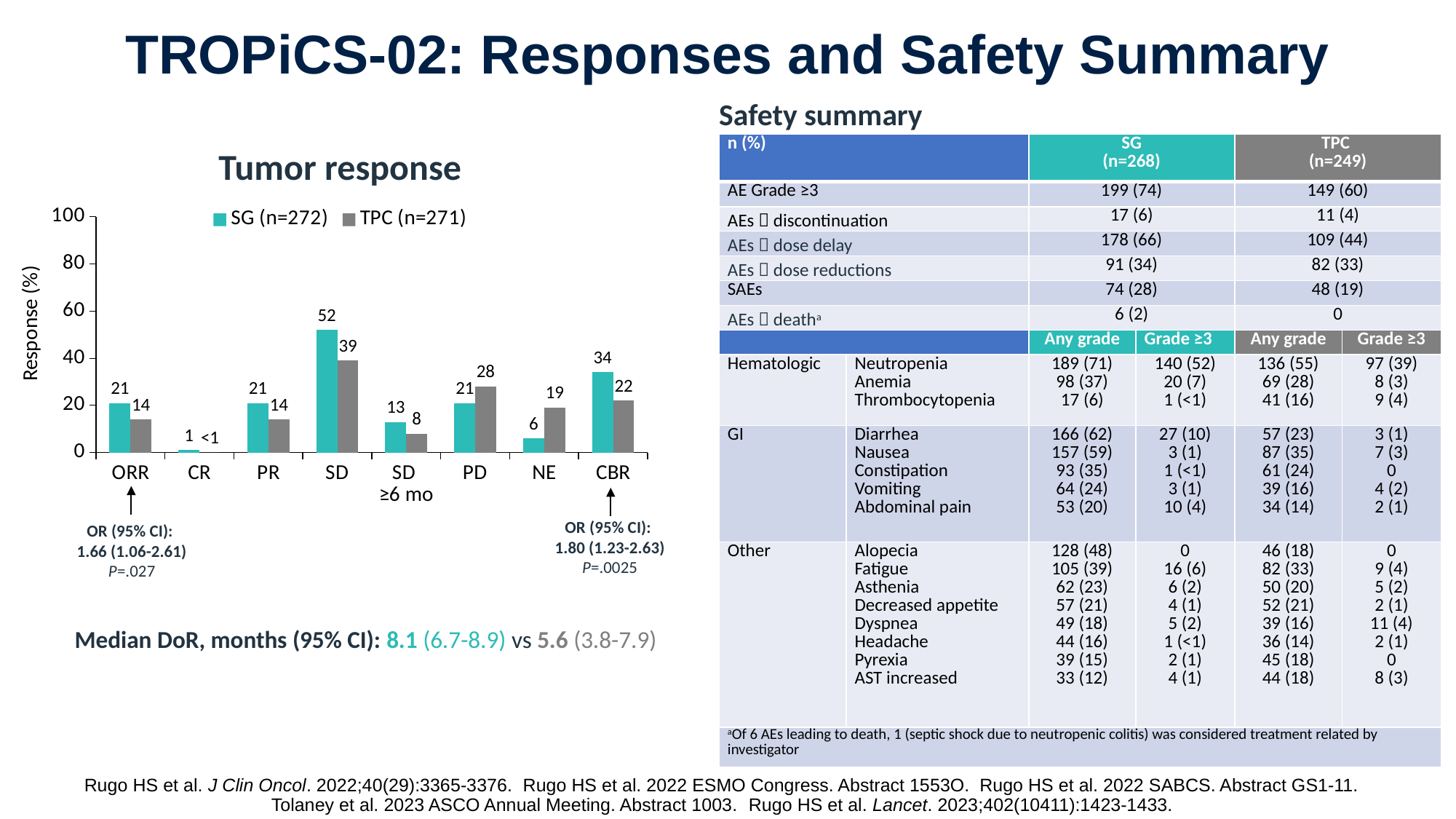
In the Tumor response chart, what is the label of the y axis? Response (%) In the Tumor response chart, how many categories are shown on the x axis? 8 In the Tumor response chart, which category has the lowest value for TPC (n=271)? CR What kind of chart is the Tumor response chart? bar chart In the Tumor response chart, how many series does the legend list? 2 In the Tumor response chart, what is the value for SG (n=272) for SD? 52 In the Tumor response chart, what is the value for TPC (n=271) for PD? 28 In the Tumor response chart, what is the value for SG (n=272) for CBR? 34 In the Tumor response chart, which series has the larger value for NE, SG (n=272) or TPC (n=271)? TPC (n=271) In the Tumor response chart, what is the value for TPC (n=271) for CR? <1 In the Tumor response chart, what is the difference between SG (n=272) and TPC (n=271) for SD? 13 In the Tumor response chart, which category has the highest value for SG (n=272)? SD